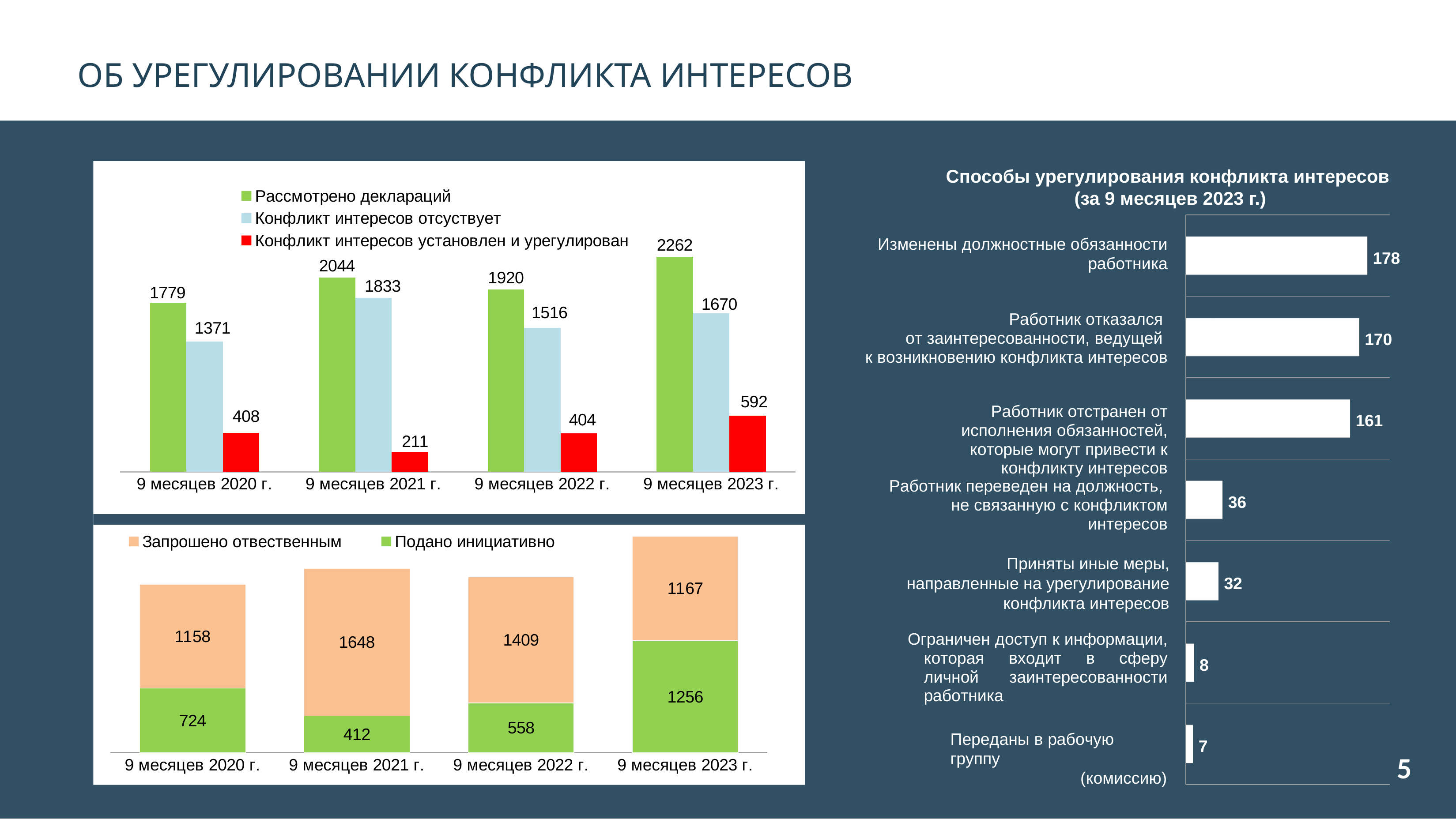
In the top-left chart, how many series does the legend list? 3 In the bottom-left chart, what is the total of the stacked bar for '9 месяцев 2023 г.'? 2423 In the bottom-left chart, what is the value of 'Подано инициативно' for '9 месяцев 2020 г.'? 724 In the bottom-left chart, which is larger for '9 месяцев 2021 г.': 'Запрошено отвественным' or 'Подано инициативно'? Запрошено отвественным In the chart 'Способы урегулирования конфликта интересов', what is the value for 'Работник отстранен от исполнения обязанностей, которые могут привести к конфликту интересов'? 161 In the top-left chart, what is the value of 'Рассмотрено деклараций' for '9 месяцев 2023 г.'? 2262 In the bottom-left chart, how many periods are shown on the x axis? 4 In the top-left chart, what is the difference between 'Рассмотрено деклараций' and 'Конфликт интересов отсуствует' for '9 месяцев 2022 г.'? 404 What type of chart is 'Способы урегулирования конфликта интересов'? Bar chart In the chart 'Способы урегулирования конфликта интересов', which category has the highest value? Изменены должностные обязанности работника In the top-left chart, what is the value of 'Конфликт интересов установлен и урегулирован' for '9 месяцев 2021 г.'? 211 In the top-left chart, which period has the lowest value for 'Конфликт интересов установлен и урегулирован'? 9 месяцев 2021 г.